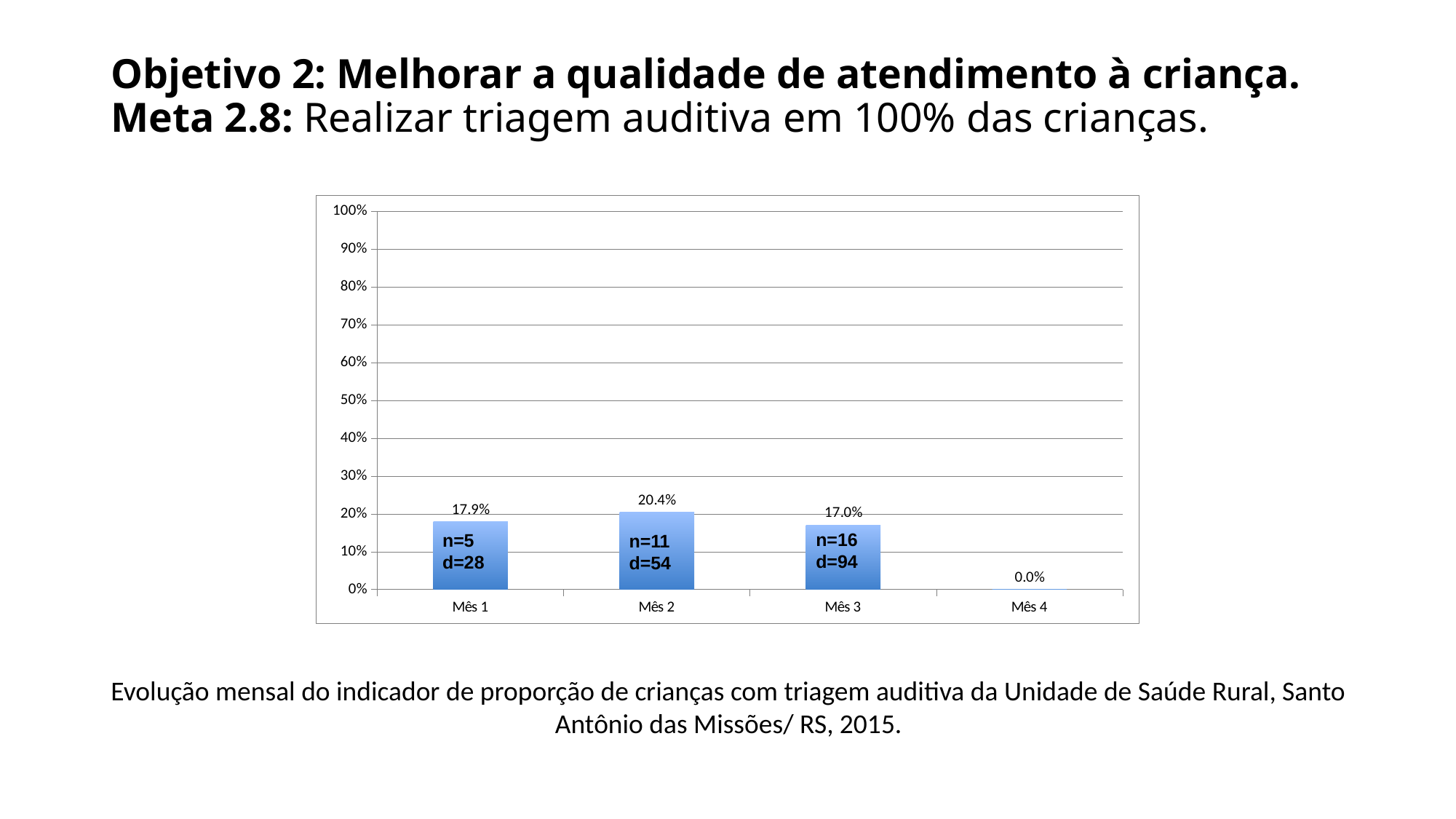
What is the value for Mês 2? 20.4% What is the difference between the values for Mês 2 and Mês 1? 2.5% Which month has the lowest value? Mês 4 How many months are shown on the x axis? 4 Which month has the highest value? Mês 2 What is the value for Mês 3? 17.0% What is the value for Mês 4? 0.0% Is the value for Mês 2 greater or less than 30%? less What is the value for Mês 1? 17.9% Which is larger, the value for Mês 1 or the value for Mês 3? Mês 1 What is the numerator (n) shown inside the bar for Mês 3? n=16 What kind of chart is shown on the slide? bar chart